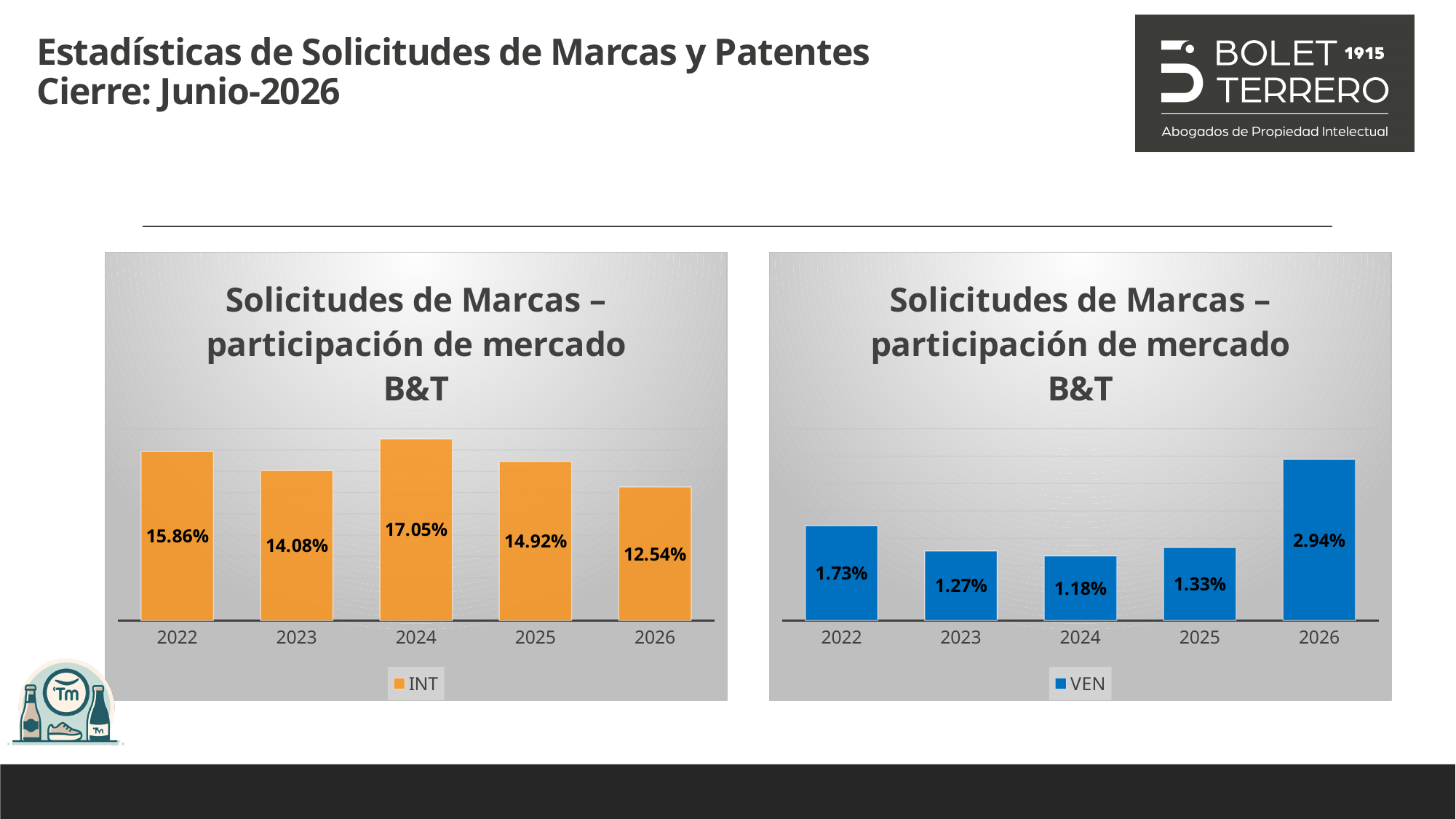
In the left chart (INT), which year has the lowest market share? 2026 In the left chart (INT), what is the market share value for 2024? 17.05% How many years are shown on the x axis of the left chart (INT)? 5 In the right chart (VEN), what is the market share value for 2026? 2.94% What is the legend entry of the left chart? INT In the right chart (VEN), what is the difference between the 2026 value and the 2024 value? 1.76% What type of chart is the right chart (VEN)? Bar chart In the left chart (INT), what is the difference between the 2024 value and the 2026 value? 4.51% In the right chart (VEN), which year has the larger value, 2023 or 2025? 2025 In the right chart (VEN), which year has the lowest market share? 2024 In the left chart (INT), which year has the larger value, 2022 or 2023? 2022 In the right chart (VEN), which year has the highest market share? 2026